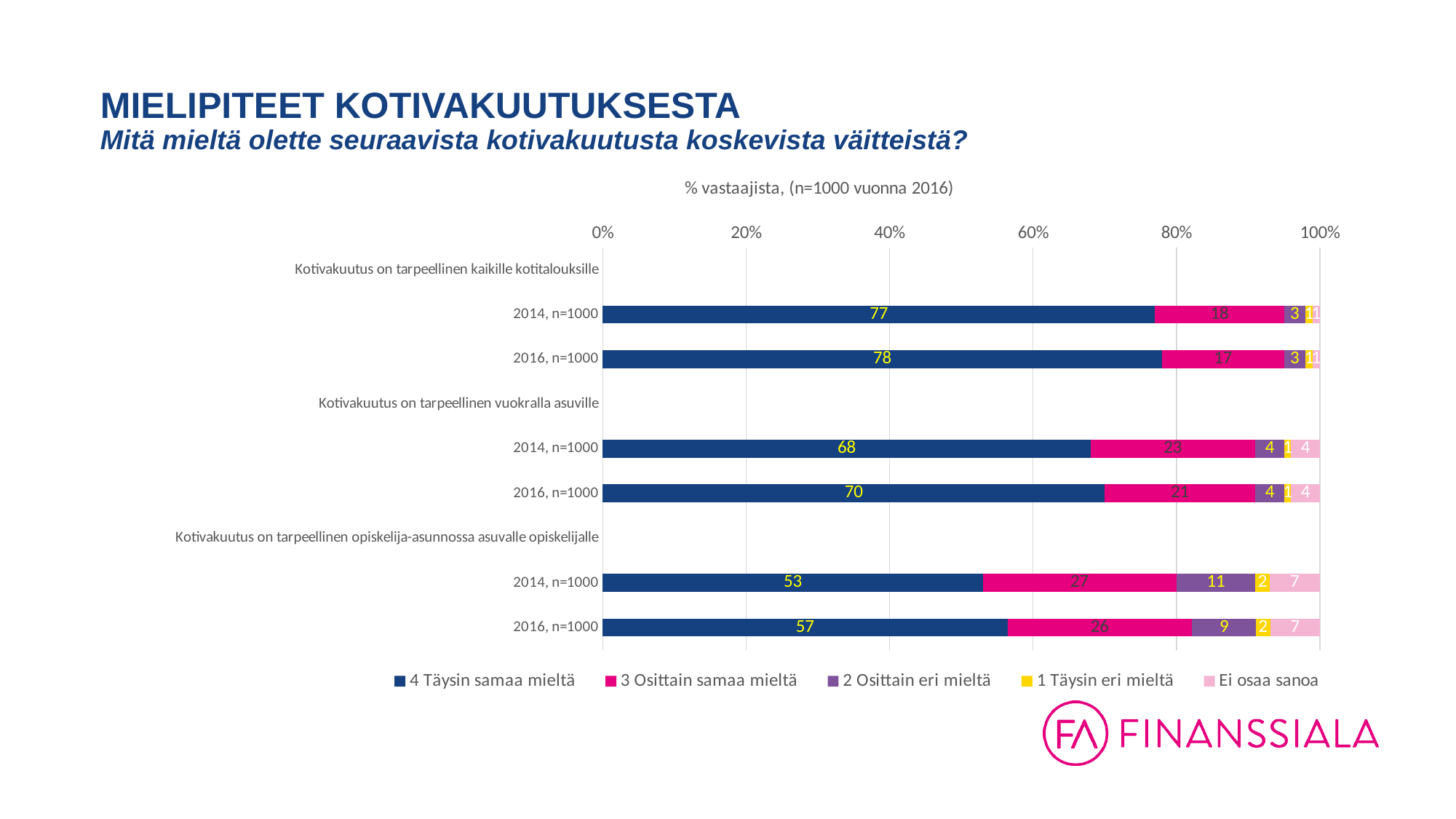
What kind of chart is shown on the slide? Stacked bar chart What percentage of respondents in 2016 answered "4 Täysin samaa mieltä" to "Kotivakuutus on tarpeellinen kaikille kotitalouksille"? 78 Is the "4 Täysin samaa mieltä" value for "Kotivakuutus on tarpeellinen vuokralla asuville" in 2016 greater or less than 60%? greater What is the "2 Osittain eri mieltä" value for "Kotivakuutus on tarpeellinen opiskelija-asunnossa asuvalle opiskelijalle" in 2014? 11 For "Kotivakuutus on tarpeellinen kaikille kotitalouksille", was the "3 Osittain samaa mieltä" share larger in 2014 or 2016? 2014 How many series does the legend list? 5 Which bar has the highest "4 Täysin samaa mieltä" value? Kotivakuutus on tarpeellinen kaikille kotitalouksille, 2016 What is the total of the stacked bar for "Kotivakuutus on tarpeellinen vuokralla asuville" in 2014? 100 What is the "Ei osaa sanoa" value for "Kotivakuutus on tarpeellinen opiskelija-asunnossa asuvalle opiskelijalle" in 2016? 7 Which bar has the lowest "4 Täysin samaa mieltä" value? Kotivakuutus on tarpeellinen opiskelija-asunnossa asuvalle opiskelijalle, 2014 What is the "3 Osittain samaa mieltä" value for "Kotivakuutus on tarpeellinen vuokralla asuville" in 2014? 23 By how many percentage points did the "4 Täysin samaa mieltä" share for "Kotivakuutus on tarpeellinen opiskelija-asunnossa asuvalle opiskelijalle" change from 2014 to 2016? 4